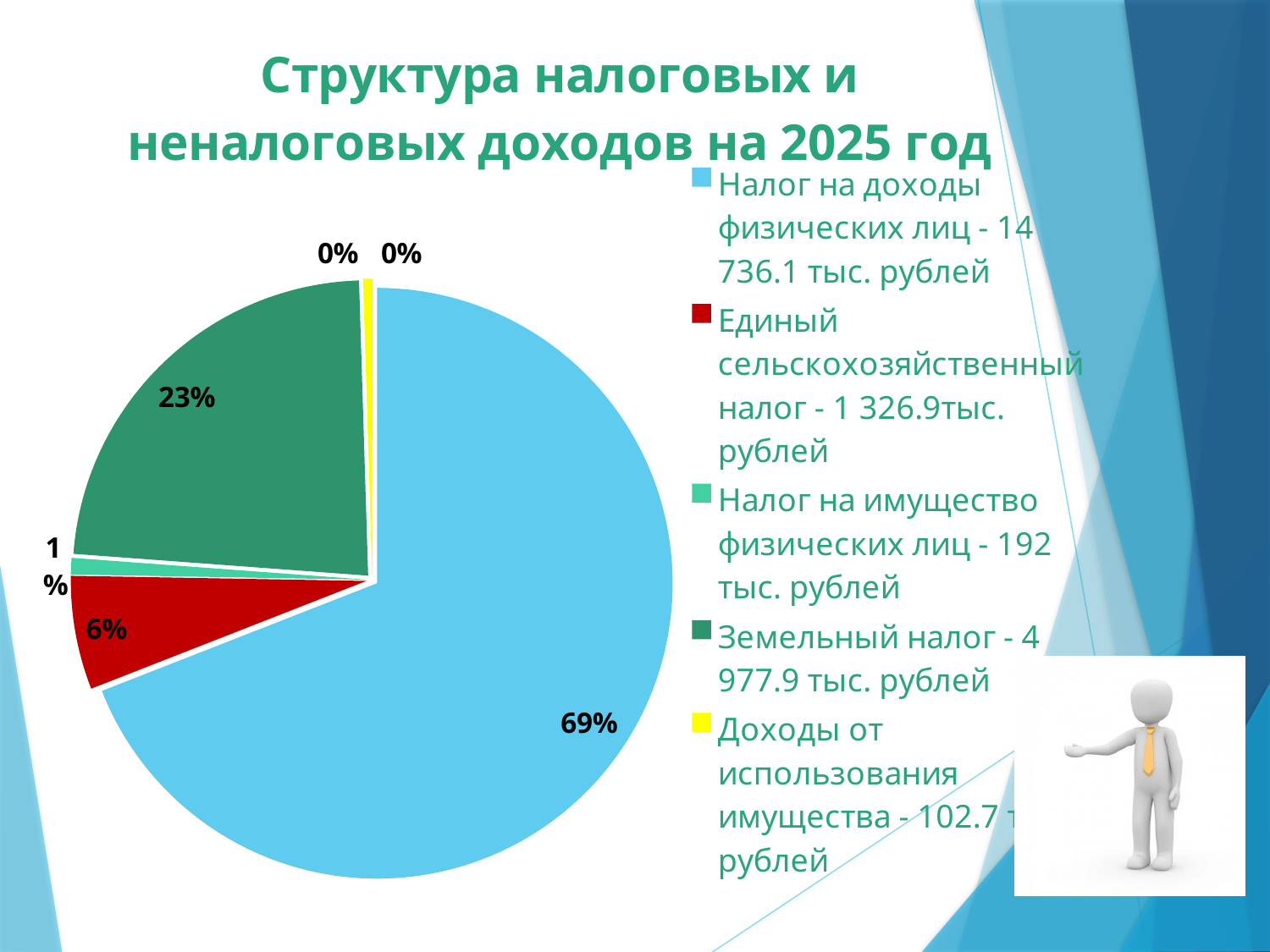
What share of the pie does Земельный налог take? 23% What is the title of the chart? Структура налоговых и неналоговых доходов на 2025 год Which category has the largest slice of the pie? Налог на доходы физических лиц What share of the pie does Налог на имущество физических лиц take? 1% What share of the pie does Доходы от использования имущества take? 0% How many entries does the legend list? 5 What colour is the slice for Единый сельскохозяйственный налог? red What kind of chart is shown on the slide? pie chart What is the difference in percentage points between the Земельный налог slice and the Единый сельскохозяйственный налог slice? 17% Which is larger: the slice for Земельный налог or the slice for Единый сельскохозяйственный налог? Земельный налог